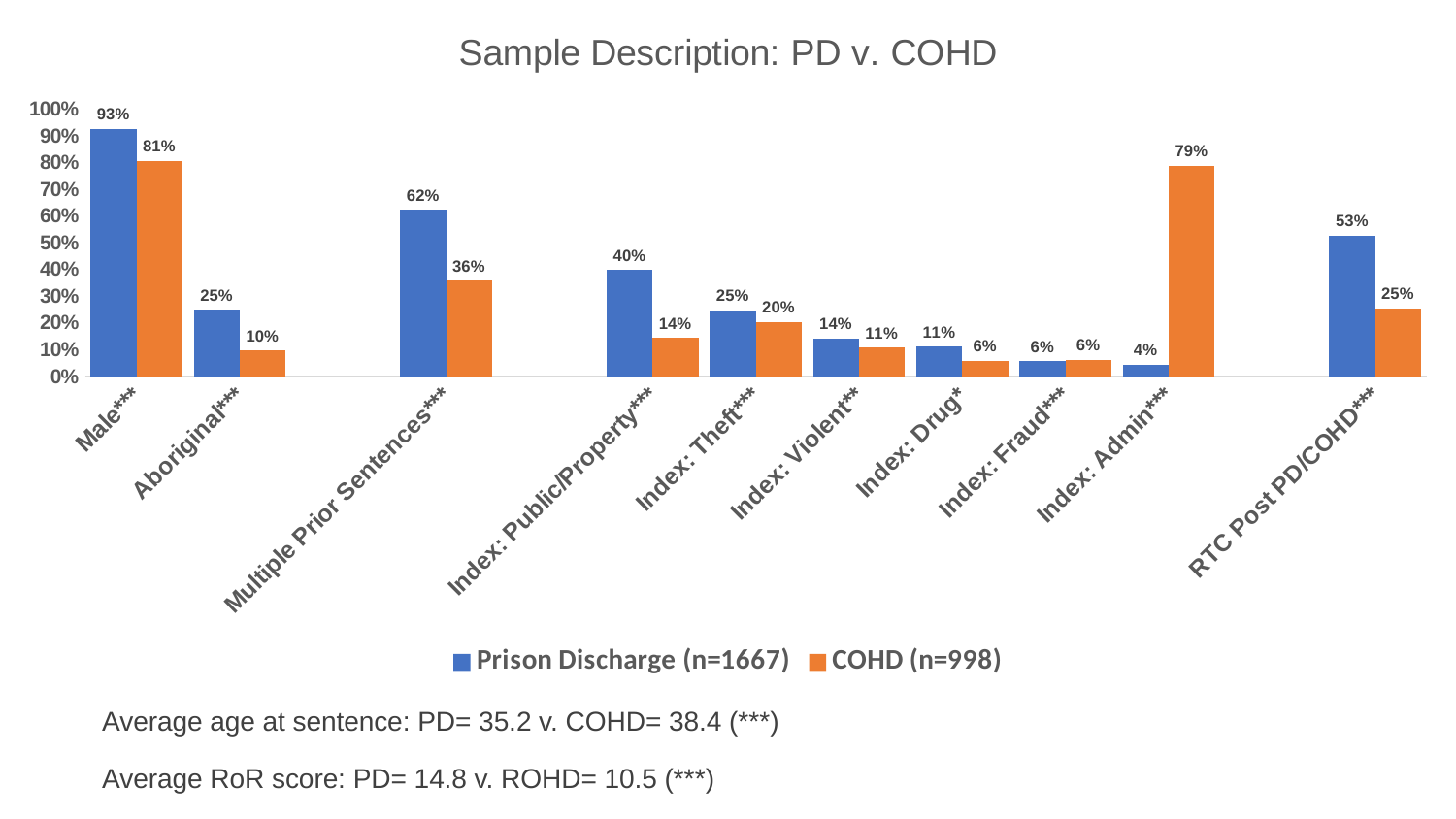
What kind of chart is shown on the slide? Bar chart How many categories are shown on the x axis? 10 What is the COHD (n=998) value for Multiple Prior Sentences***? 36% What is the difference between the Prison Discharge (n=1667) and COHD (n=998) values for RTC Post PD/COHD***? 28% What is the title of the chart? Sample Description: PD v. COHD What is the Prison Discharge (n=1667) value for Male***? 93% How many series does the legend list? 2 What is the difference between the Prison Discharge (n=1667) and COHD (n=998) values for Index: Public/Property***? 26% Which series has the larger value for Index: Admin***, Prison Discharge (n=1667) or COHD (n=998)? COHD (n=998) Which category has the highest Prison Discharge (n=1667) value? Male*** Which category has the lowest Prison Discharge (n=1667) value? Index: Admin*** What is the COHD (n=998) value for Index: Admin***? 79%